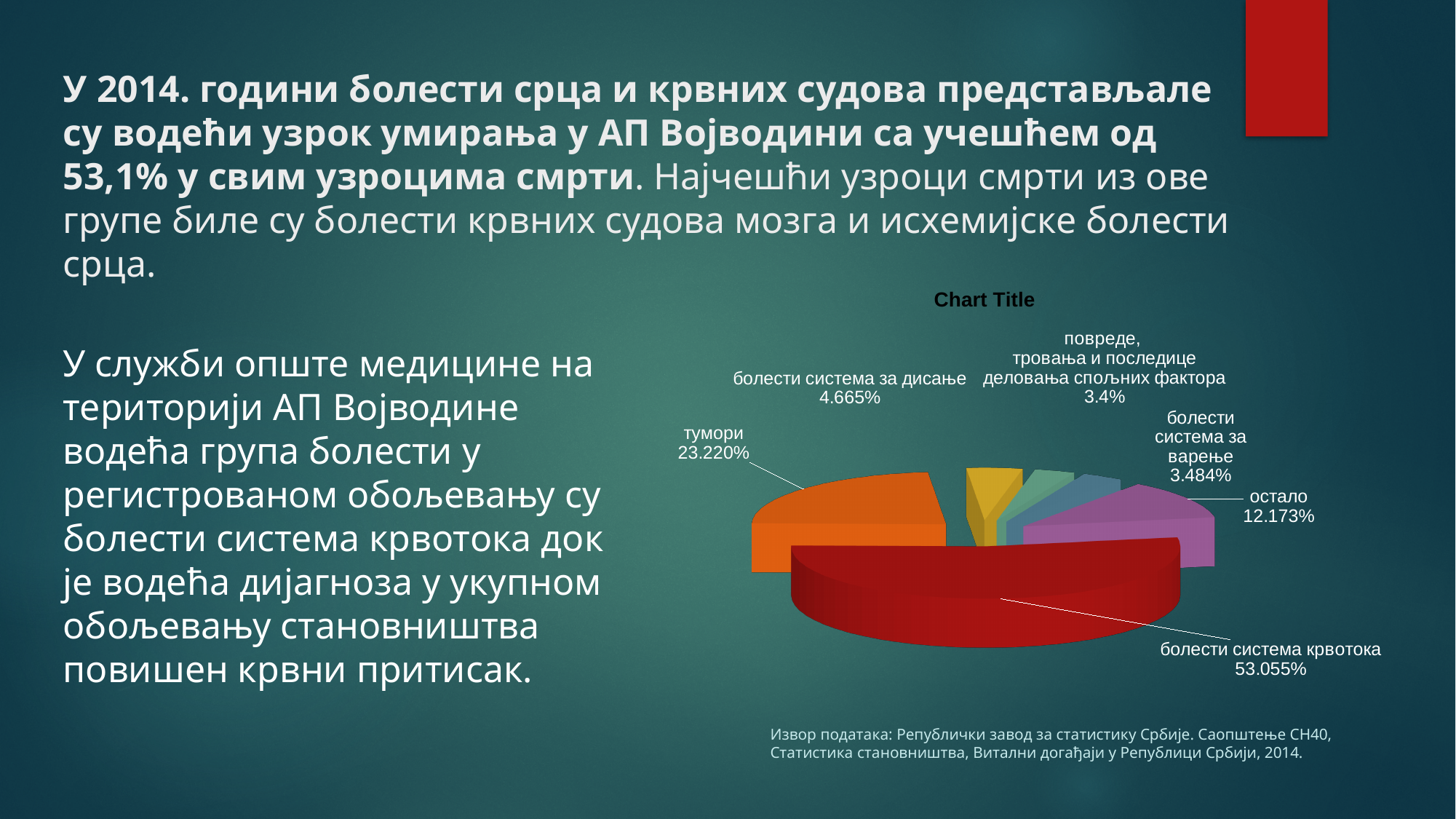
How many slices does the pie chart have? 6 Which category has the largest slice of the pie? болести система крвотока Which slice is larger: тумори or остало? тумори What share of the pie is labelled for болести система за дисање? 4.665% What share of the pie is labelled for болести система крвотока? 53.055% What share of the pie is labelled for болести система за варење? 3.484% What kind of chart is shown on the slide? pie chart What is the difference in percentage points between болести система крвотока and тумори? 29.835 What share of the pie is labelled for остало? 12.173% What is the title of the chart? Chart Title What share of the pie is labelled for тумори? 23.220% Which category has the smallest slice of the pie? повреде, тровања и последице деловања спољних фактора